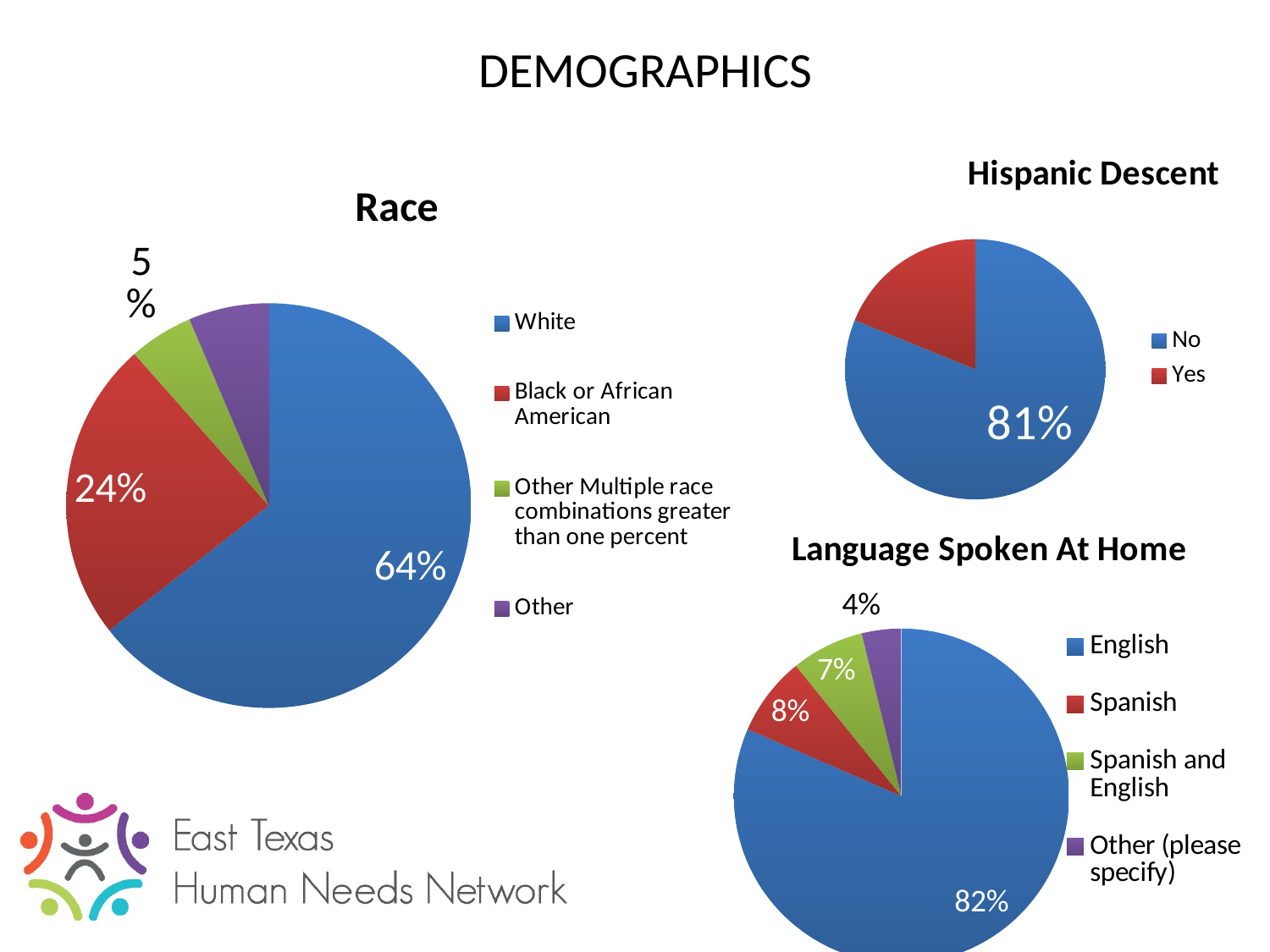
In the Race chart, what percentage is shown for Black or African American? 24% In the Language Spoken At Home chart, what percentage is shown for English? 82% In the Language Spoken At Home chart, what percentage is shown for Spanish? 8% In the Language Spoken At Home chart, what is the difference between the Spanish and Spanish and English percentages? 1% What type of chart is the Hispanic Descent chart? Pie chart In the Race chart, what is the difference between the White and Black or African American percentages? 40% In the Race chart, what percentage is shown for White? 64% In the Hispanic Descent chart, which is larger, No or Yes? No In the Language Spoken At Home chart, which category has the smallest slice? Other (please specify) How many categories does the legend of the Race chart list? 4 In the Hispanic Descent chart, what percentage is shown for No? 81% In the Race chart, which category has the largest slice? White